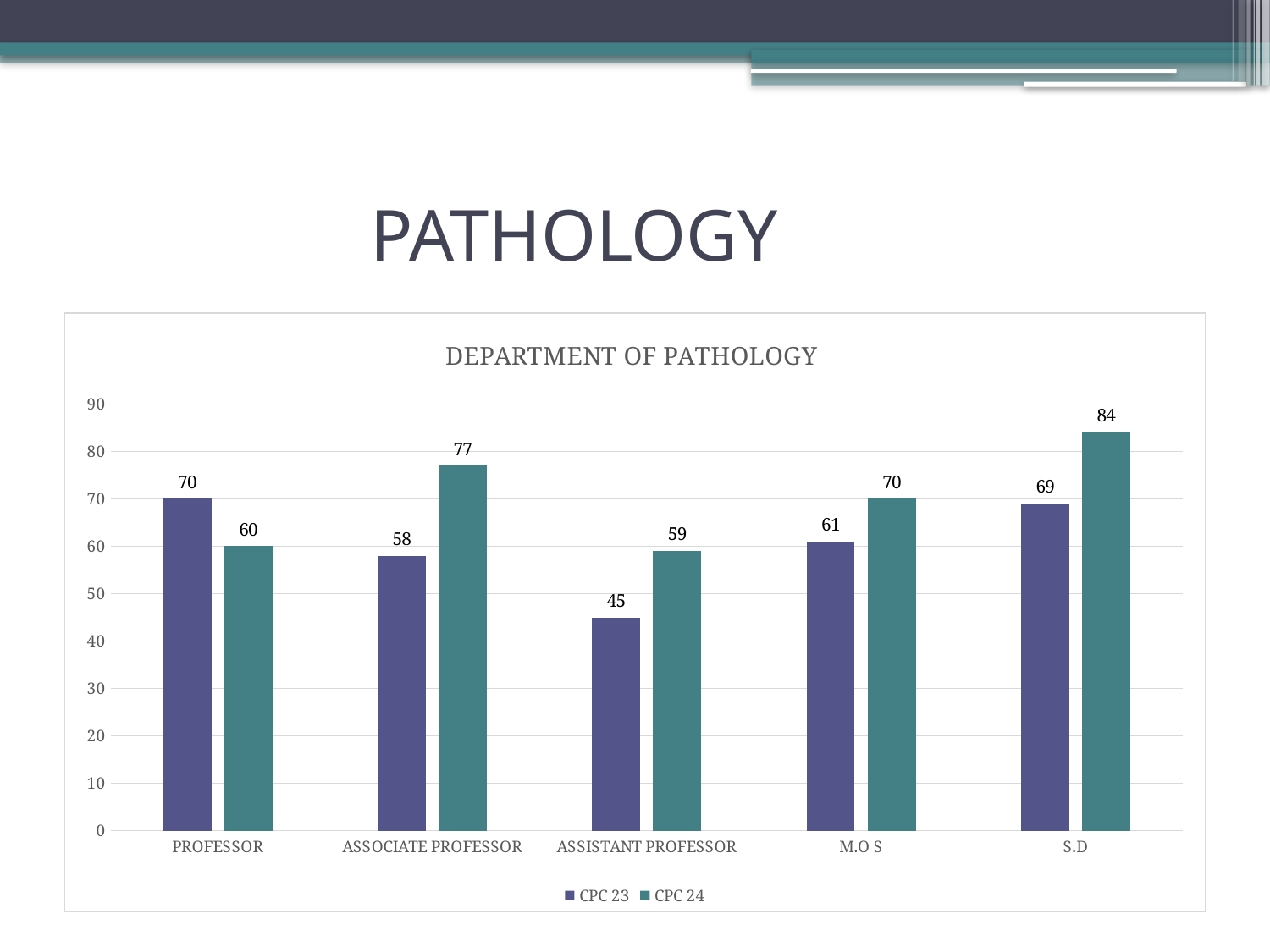
What is the difference between the CPC 24 and CPC 23 values for ASSISTANT PROFESSOR? 14 Is the CPC 24 value for S.D greater or less than 80? greater Which category has the highest CPC 24 value? S.D What is the CPC 24 value for ASSOCIATE PROFESSOR? 77 Which category has the lowest CPC 23 value? ASSISTANT PROFESSOR What is the title of the chart? DEPARTMENT OF PATHOLOGY What is the CPC 23 value for PROFESSOR? 70 For PROFESSOR, which is larger: the CPC 23 value or the CPC 24 value? CPC 23 How many series does the legend list? 2 What is the CPC 23 value for ASSISTANT PROFESSOR? 45 How many categories are shown on the x axis? 5 What kind of chart is shown on the slide? bar chart